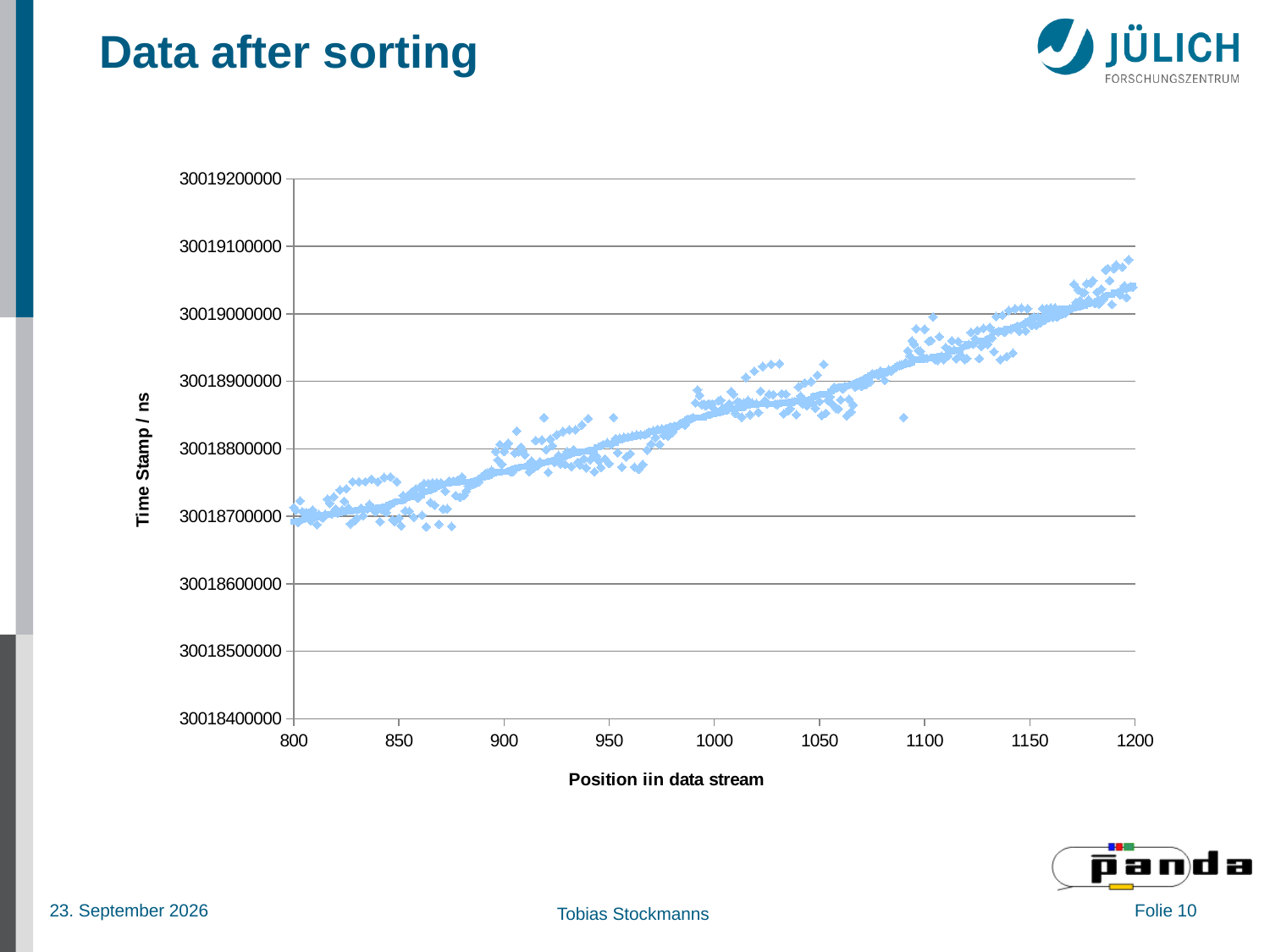
Are the time stamp values at position 1100 greater or less than 30018900000? greater Are the time stamp values near position 1000 greater or less than 30018800000? greater Are the time stamp values at position 1200 greater or less than 30019000000? greater What is the title of the chart's y axis? Time Stamp / ns Do the time stamp values rise or fall as the position in the data stream increases from 800 to 1200? rise What is the title of the chart's x axis? Position iin data stream What is the lowest value shown on the x axis? 800 What kind of chart is shown on the slide? scatter plot